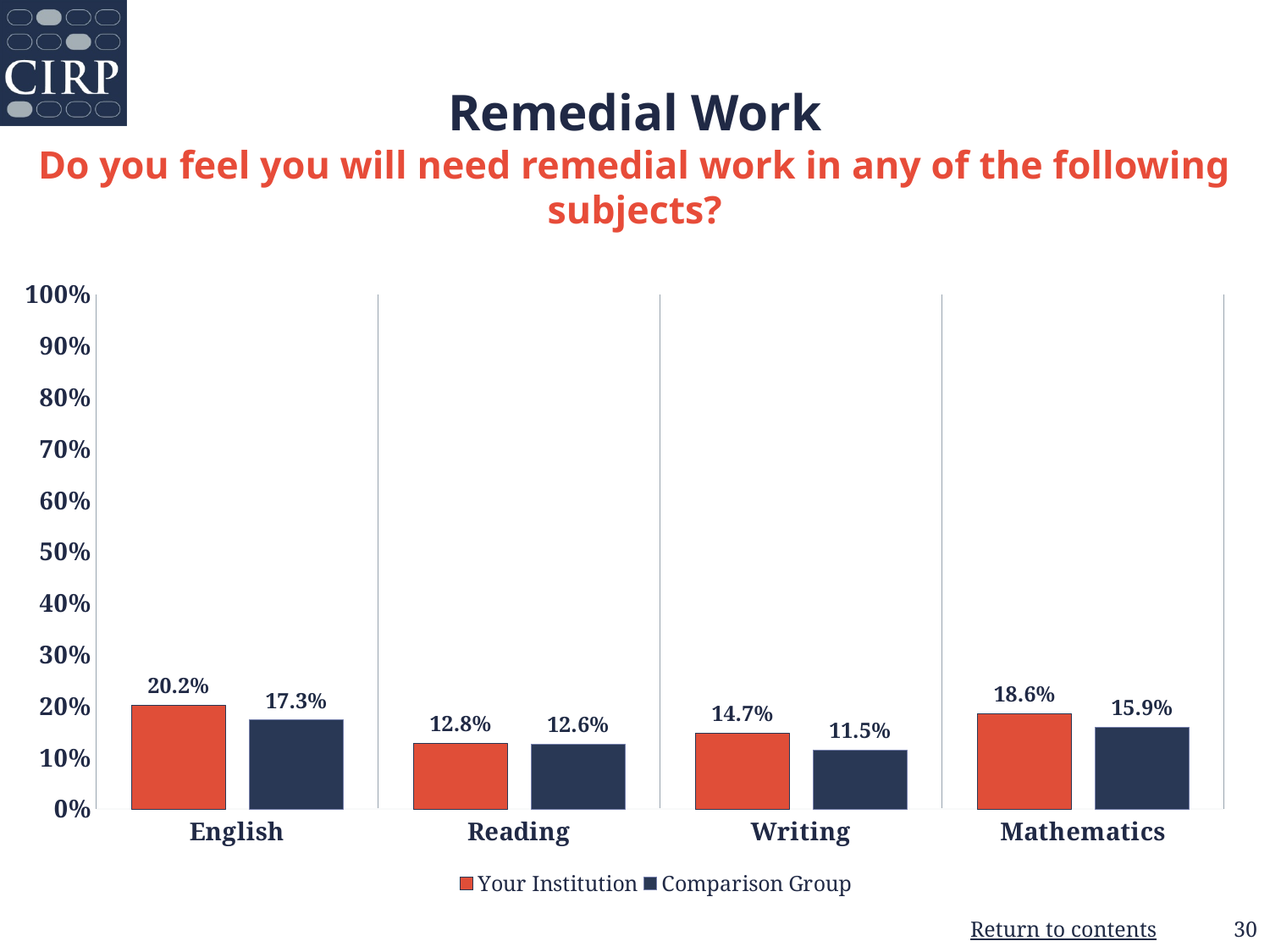
What is the value for Comparison Group for Writing? 11.5% How many series does the legend list? 2 What is the difference between Your Institution and Comparison Group for English? 2.9% Which subject has the lowest value for Comparison Group? Writing What kind of chart is shown on the slide? bar chart How many subjects are shown on the x axis? 4 Which subject has the highest value for Your Institution? English What is the difference between Your Institution and Comparison Group for Writing? 3.2% What is the value for Your Institution for English? 20.2% Is the value for Your Institution for Reading greater or less than 20%? less Which is larger for Mathematics, Your Institution or Comparison Group? Your Institution What is the value for Comparison Group for Mathematics? 15.9%